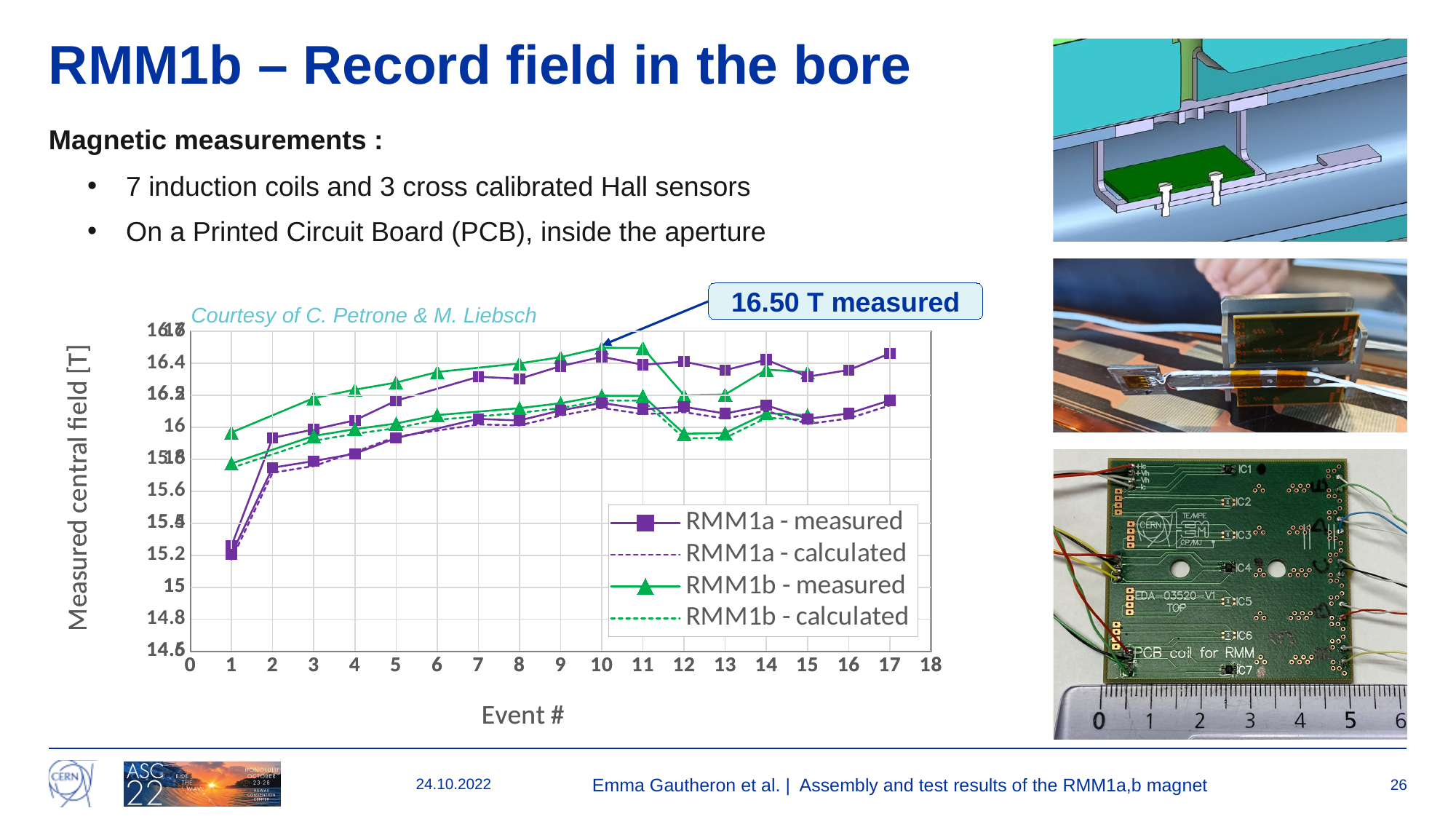
What is the title of the y axis of the chart? Measured central field [T] What type of chart is shown on the slide? line chart How many series does the chart legend list? 4 At event 1, which is larger: RMM1b - measured or RMM1a - measured? RMM1b - measured Which series reaches the highest value on the chart? RMM1b - measured Is the value of RMM1a - measured at event 17 greater or less than 16.2? greater What is the title of the x axis of the chart? Event # Is the value of RMM1b - measured at event 1 greater or less than 15.8? greater At which event number does the RMM1a - measured series reach its lowest value? 1 What peak field value is called out in the annotation box on the chart? 16.50 T Is the value of RMM1a - measured at event 1 greater or less than 15.4? less Does the RMM1a - measured series rise or fall from event 1 to event 10? rise